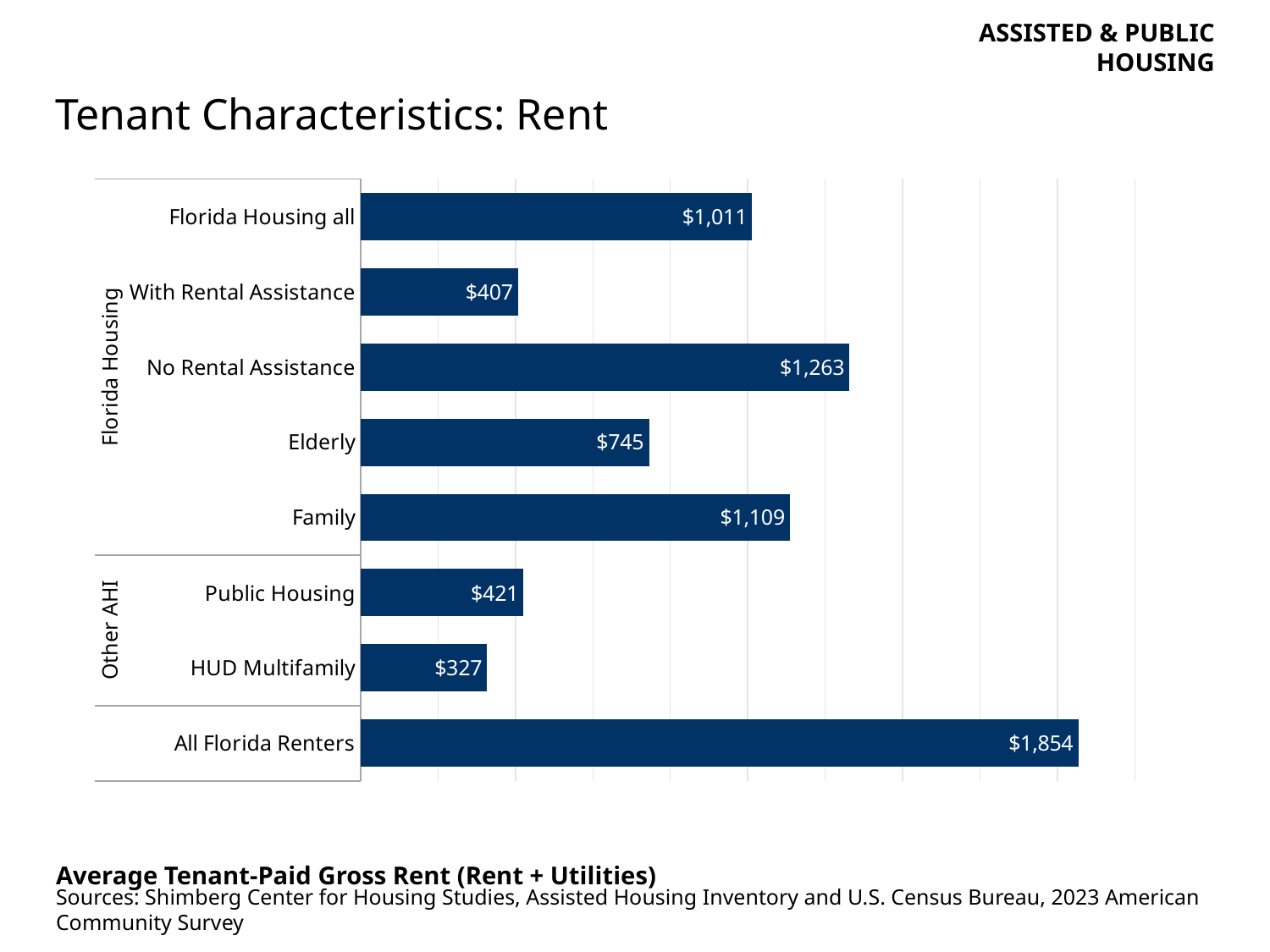
What is the value for HUD Multifamily? $327 What is the value for All Florida Renters? $1,854 Which categories are grouped under the label Other AHI? Public Housing and HUD Multifamily What is the difference between the values for No Rental Assistance and With Rental Assistance? $856 How many categories are shown in the chart? 8 What is the difference between the values for Family and Elderly? $364 What kind of chart is shown on the slide? Bar chart What is the average tenant-paid gross rent for Florida Housing all? $1,011 Which category has the highest average tenant-paid gross rent? All Florida Renters What is the value for With Rental Assistance? $407 Which is larger, the value for Public Housing or the value for HUD Multifamily? Public Housing Which category has the lowest average tenant-paid gross rent? HUD Multifamily